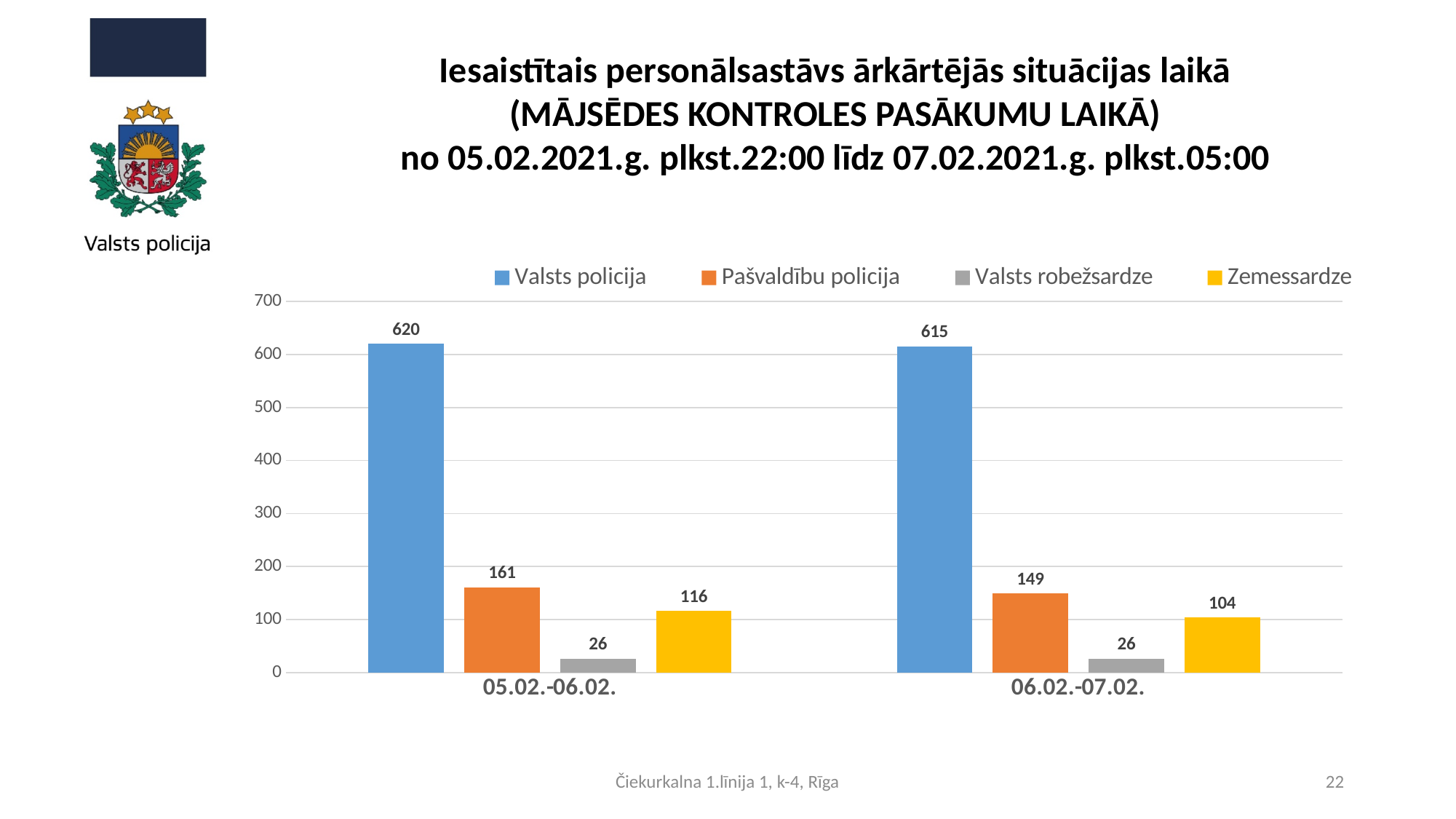
What is the value for Valsts policija in the 05.02.-06.02. period? 620 What is the difference between the Valsts policija values for 05.02.-06.02. and 06.02.-07.02.? 5 What colour represents Zemessardze in the chart? Yellow How many series does the legend list? 4 How many categories are shown on the x axis? 2 Which series has the lowest value in the 05.02.-06.02. period? Valsts robežsardze What is the value for Pašvaldību policija in the 06.02.-07.02. period? 149 What is the value for Valsts robežsardze in the 06.02.-07.02. period? 26 Which series has the highest value in the 06.02.-07.02. period? Valsts policija Which is larger: Zemessardze in 05.02.-06.02. or Zemessardze in 06.02.-07.02.? Zemessardze in 05.02.-06.02. What kind of chart is shown on the slide? Bar chart What is the value for Zemessardze in the 05.02.-06.02. period? 116